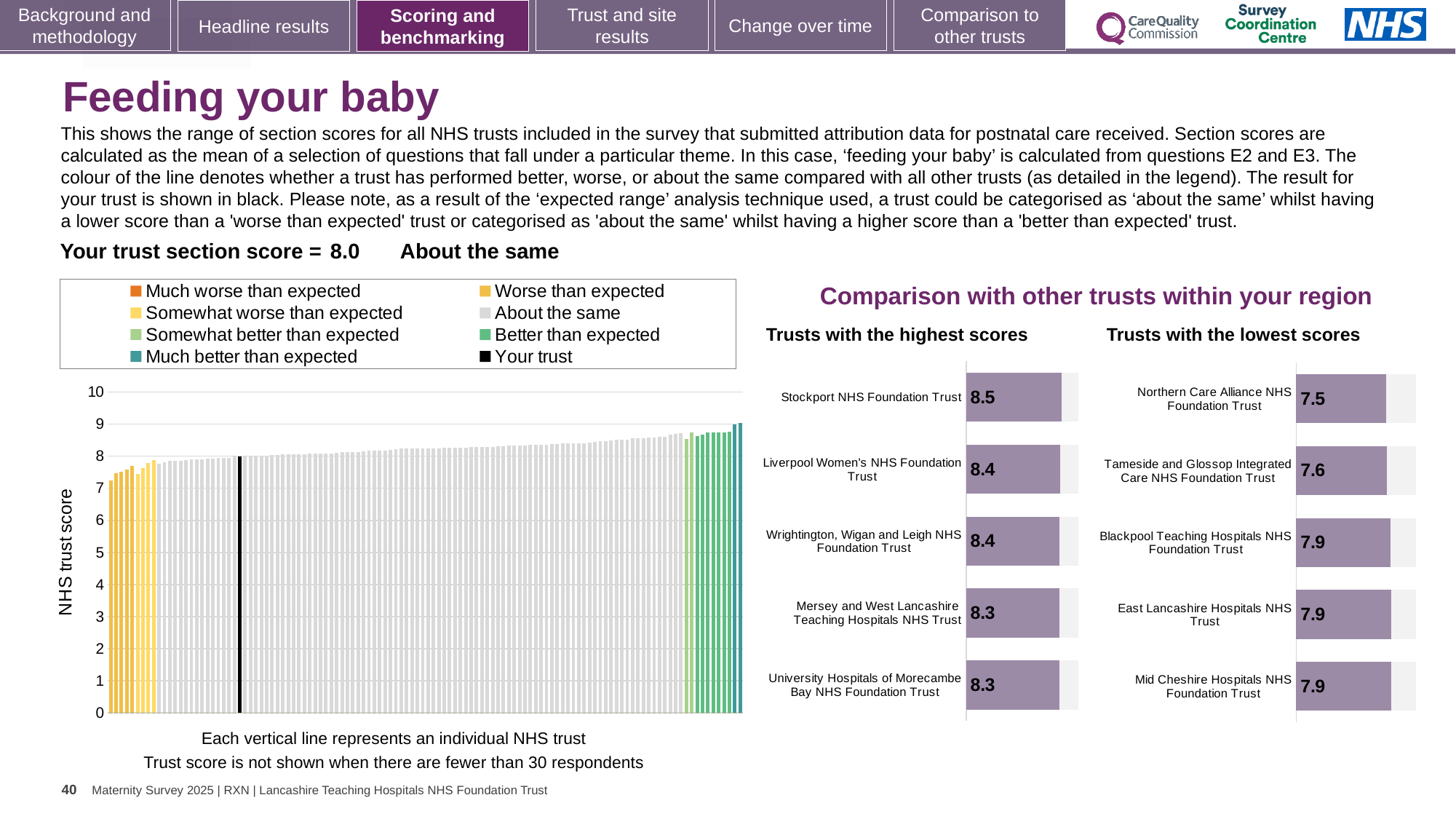
In the 'Trusts with the lowest scores' chart, which trust has the lowest score? Northern Care Alliance NHS Foundation Trust In the 'Trusts with the highest scores' chart, which trust has the highest score? Stockport NHS Foundation Trust How many trusts are shown in the 'Trusts with the highest scores' chart? 5 In the 'NHS trust score' chart on the left, do the values rise or fall from left to right? Rise How many entries does the legend above the 'NHS trust score' chart list? 8 In the 'Trusts with the lowest scores' chart, what is the difference between the scores of Blackpool Teaching Hospitals NHS Foundation Trust and Northern Care Alliance NHS Foundation Trust? 0.4 Which has the higher score: Liverpool Women's NHS Foundation Trust in the highest scores chart or Tameside and Glossop Integrated Care NHS Foundation Trust in the lowest scores chart? Liverpool Women's NHS Foundation Trust In the 'Trusts with the highest scores' chart, what is the difference between the scores of Stockport NHS Foundation Trust and Mersey and West Lancashire Teaching Hospitals NHS Trust? 0.2 In the 'Trusts with the highest scores' chart, what is the score for Stockport NHS Foundation Trust? 8.5 What kind of chart is the 'NHS trust score' chart on the left of the slide? Bar chart In the 'Trusts with the lowest scores' chart, what is the score for Northern Care Alliance NHS Foundation Trust? 7.5 In the 'NHS trust score' chart on the left, what is the section score for your trust (the black bar)? 8.0